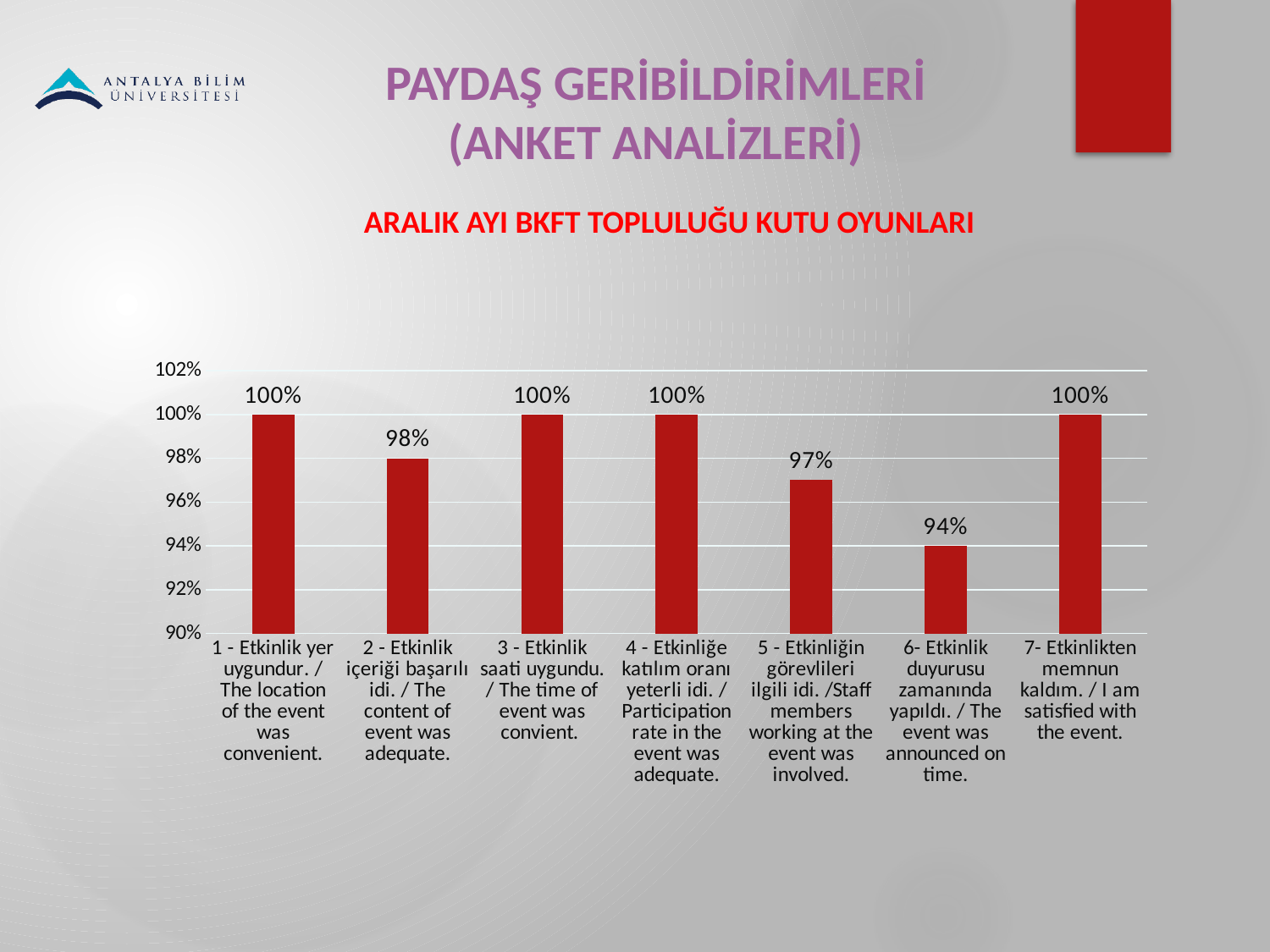
What is the difference between the value for category 2 and the value for category 6? 4% Is the value for category 6 greater or less than 96%? less What is the value for category 2 (The content of event was adequate)? 98% What is the difference between the value for category 1 and the value for category 5? 3% What is the value for category 5 (Staff members working at the event was involved)? 97% What kind of chart is shown on the slide? Bar chart How many categories are shown in the chart? 7 What is the value for category 6 (The event was announced on time)? 94% Which is larger, the value for category 5 or the value for category 6? Category 5 (97%) Which category has the lowest value? 6- Etkinlik duyurusu zamanında yapıldı. / The event was announced on time. How many categories have a value of 100%? 4 What is the value for category 7 (I am satisfied with the event)? 100%